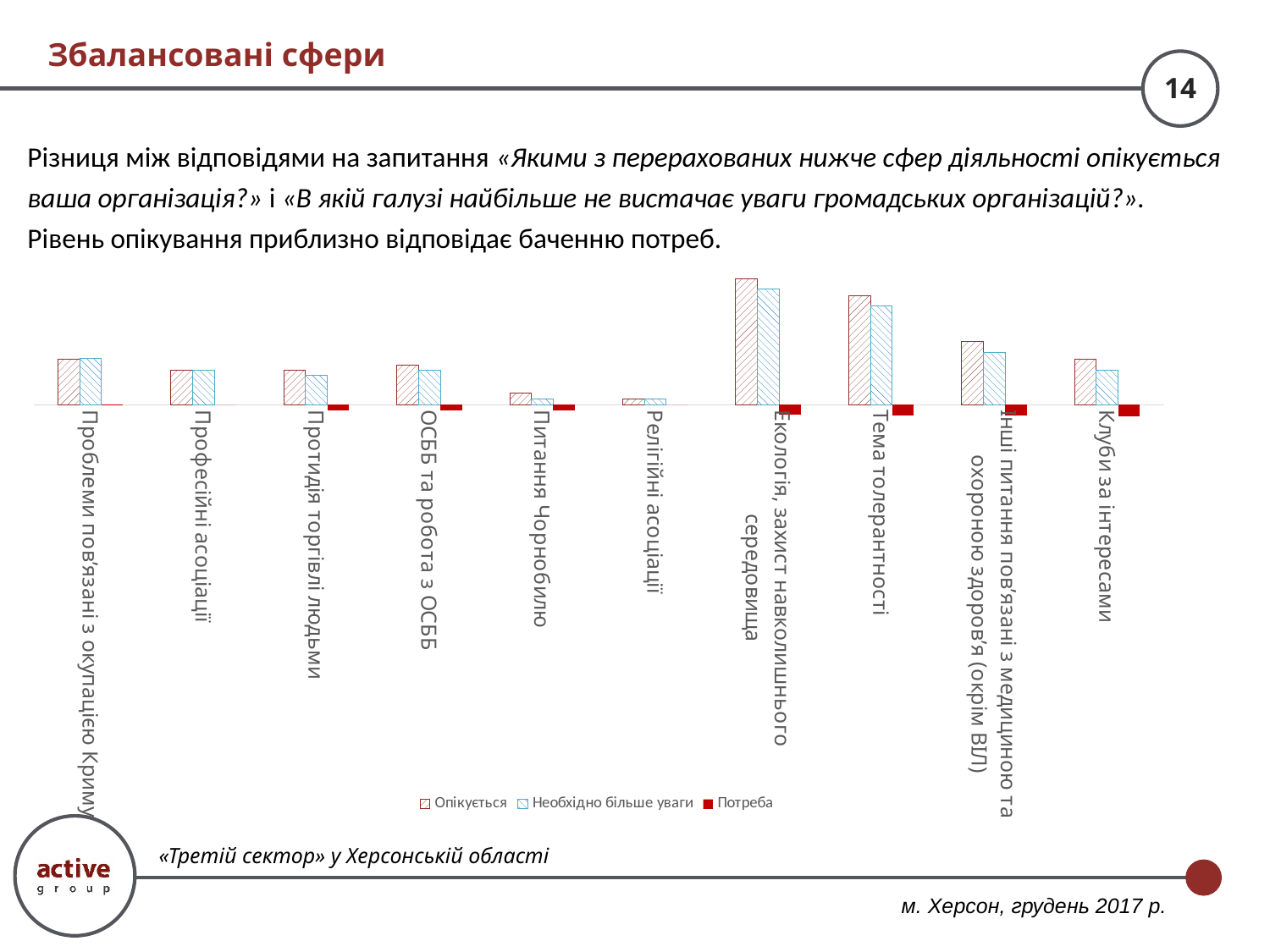
Which category has the highest value for the series «Опікується»? Екологія, захист навколишнього середовища What are the three series listed in the chart legend? Опікується, Необхідно більше уваги, Потреба Which category has the lowest value for the series «Опікується»? Релігійні асоціації How many series does the chart legend list? 3 For the series «Опікується», which is larger: «Проблеми пов'язані з окупацією Криму» or «Протидія торгівлі людьми»? Проблеми пов'язані з окупацією Криму What kind of chart is shown on the slide? bar chart How many categories (spheres of activity) are shown on the x axis of the chart? 10 Which category has the highest value for the series «Необхідно більше уваги»? Екологія, захист навколишнього середовища For the series «Опікується», which is larger: «Екологія, захист навколишнього середовища» or «Тема толерантності»? Екологія, захист навколишнього середовища For the series «Необхідно більше уваги», which is larger: «Тема толерантності» or «Клуби за інтересами»? Тема толерантності Which series in the chart is drawn as solid red bars? Потреба